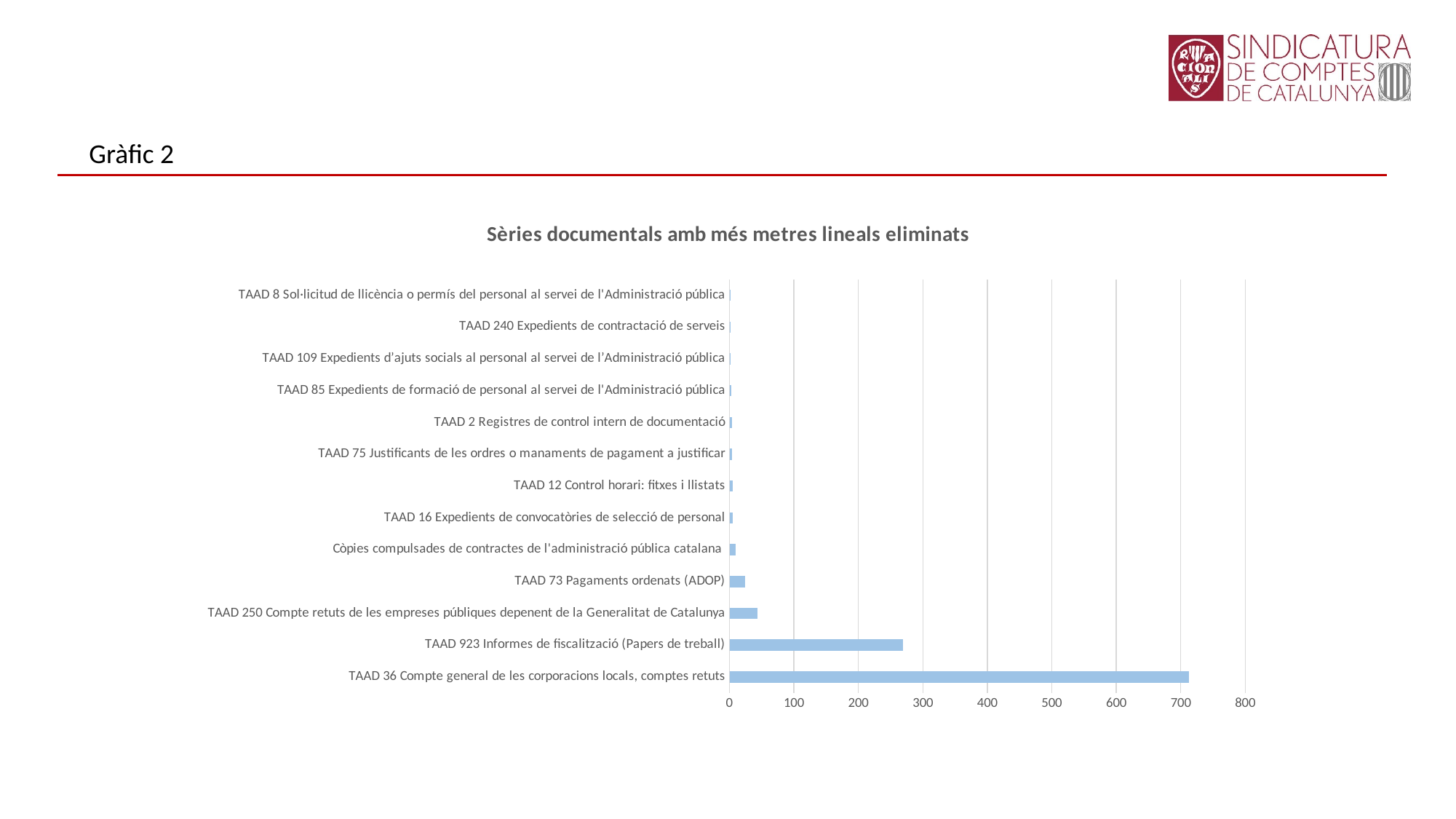
Which is larger, the value for TAAD 923 Informes de fiscalització (Papers de treball) or the value for TAAD 250 Compte retuts de les empreses públiques depenent de la Generalitat de Catalunya? TAAD 923 Informes de fiscalització (Papers de treball) Is the value for TAAD 73 Pagaments ordenats (ADOP) greater or less than 100? less Is the value for TAAD 36 Compte general de les corporacions locals, comptes retuts greater or less than 600? greater What kind of chart is shown on the slide? bar chart What is the title of the chart? Sèries documentals amb més metres lineals eliminats What is the highest value shown on the horizontal axis? 800 How many categories are plotted in the chart? 13 Is the value for TAAD 250 Compte retuts de les empreses públiques depenent de la Generalitat de Catalunya greater or less than 100? less Which category has the highest value? TAAD 36 Compte general de les corporacions locals, comptes retuts Which is larger, the value for TAAD 36 Compte general de les corporacions locals, comptes retuts or the value for TAAD 923 Informes de fiscalització (Papers de treball)? TAAD 36 Compte general de les corporacions locals, comptes retuts